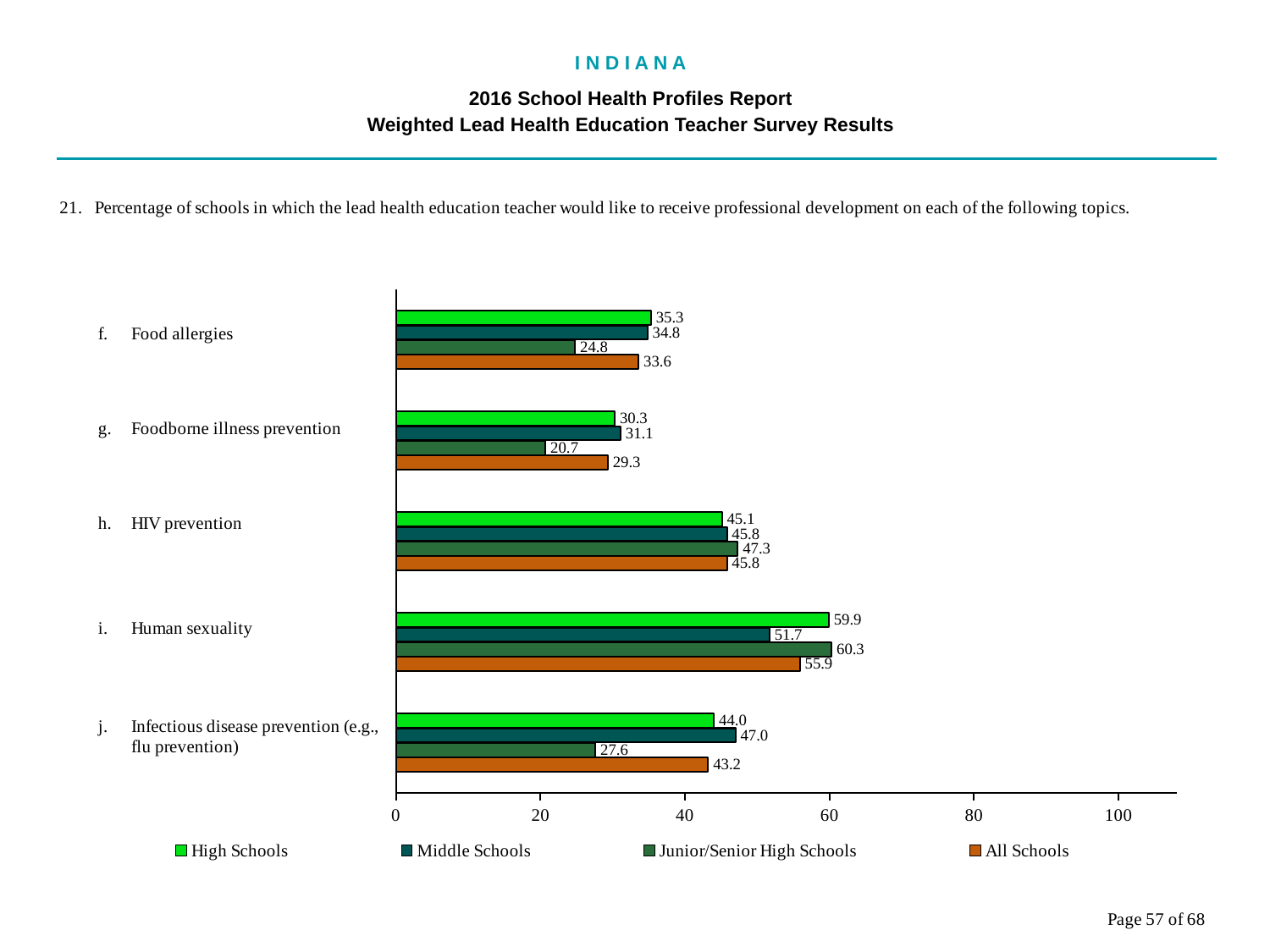
What is the value for All Schools for Human sexuality? 55.9 Which is larger for HIV prevention: the Middle Schools value or the Junior/Senior High Schools value? Junior/Senior High Schools How many series does the legend list? 4 How many topics are shown on the chart? 5 Is the value for Junior/Senior High Schools for Human sexuality greater or less than 60? greater What is the value for High Schools for Food allergies? 35.3 What is the value for Middle Schools for Infectious disease prevention (e.g., flu prevention)? 47.0 Which topic has the highest value for High Schools? Human sexuality What kind of chart is shown on the slide? bar chart What is the value for Junior/Senior High Schools for Foodborne illness prevention? 20.7 Which topic has the lowest value for All Schools? Foodborne illness prevention What is the difference between the High Schools and Junior/Senior High Schools values for Infectious disease prevention (e.g., flu prevention)? 16.4